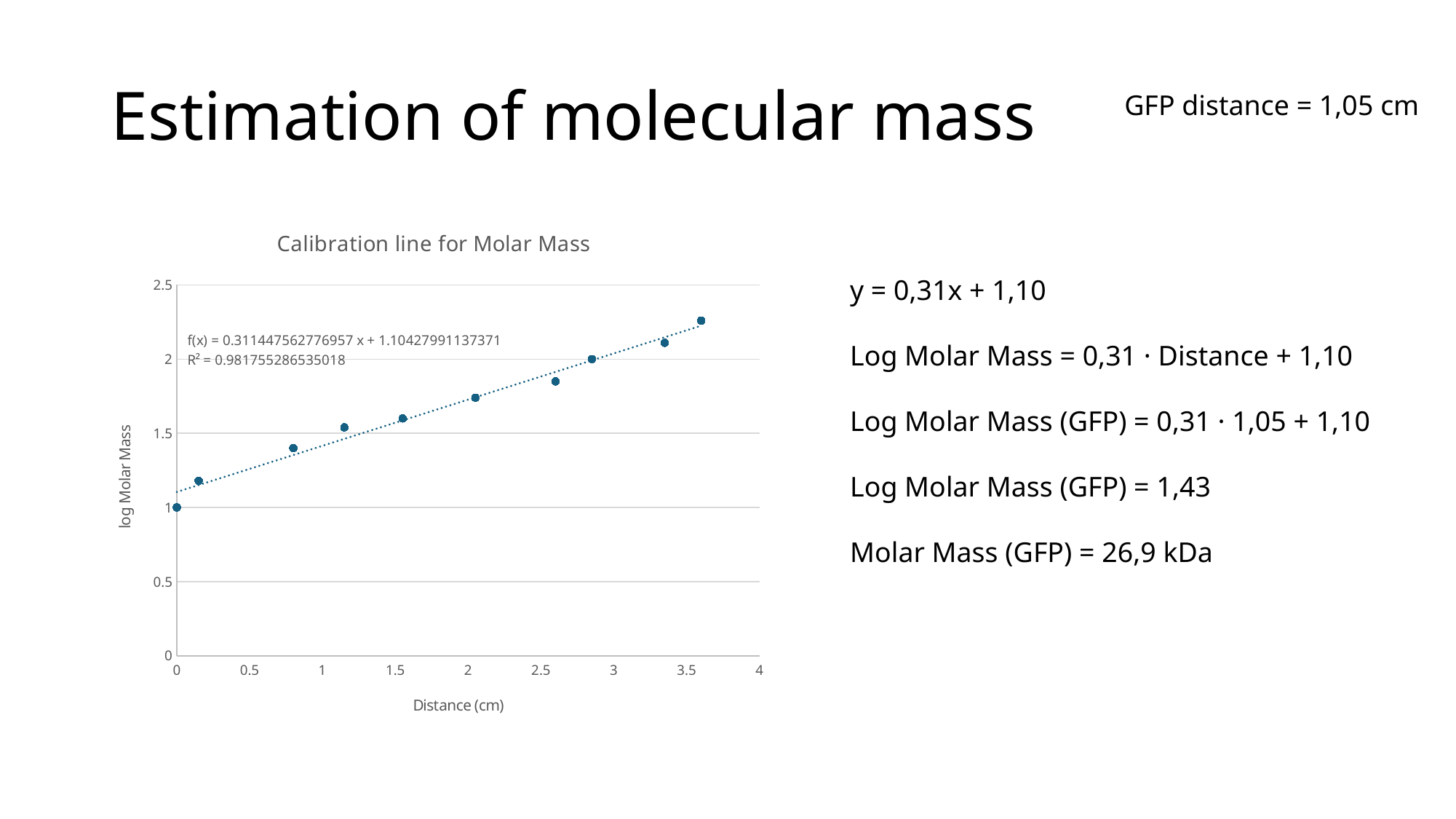
What is the R² value printed on the chart for the trendline? 0.981755286535018 Is the log Molar Mass value of the rightmost data point (at about 3.6 cm) greater or less than 2? greater Which data point has the highest log Molar Mass value: the one at about 0.15 cm or the one at about 3.6 cm? The one at about 3.6 cm What is the maximum value shown on the y axis of the chart? 2.5 Is the log Molar Mass value of the data point at about 2 cm greater or less than 1.5? greater How many data points are plotted in the chart? 10 What is the label of the x axis of the chart? Distance (cm) Do the log Molar Mass values rise or fall as Distance increases? Rise Is the log Molar Mass value of the data point at about 0.8 cm greater or less than 1.5? less What kind of chart is shown on the slide? Scatter plot What is the title of the chart? Calibration line for Molar Mass